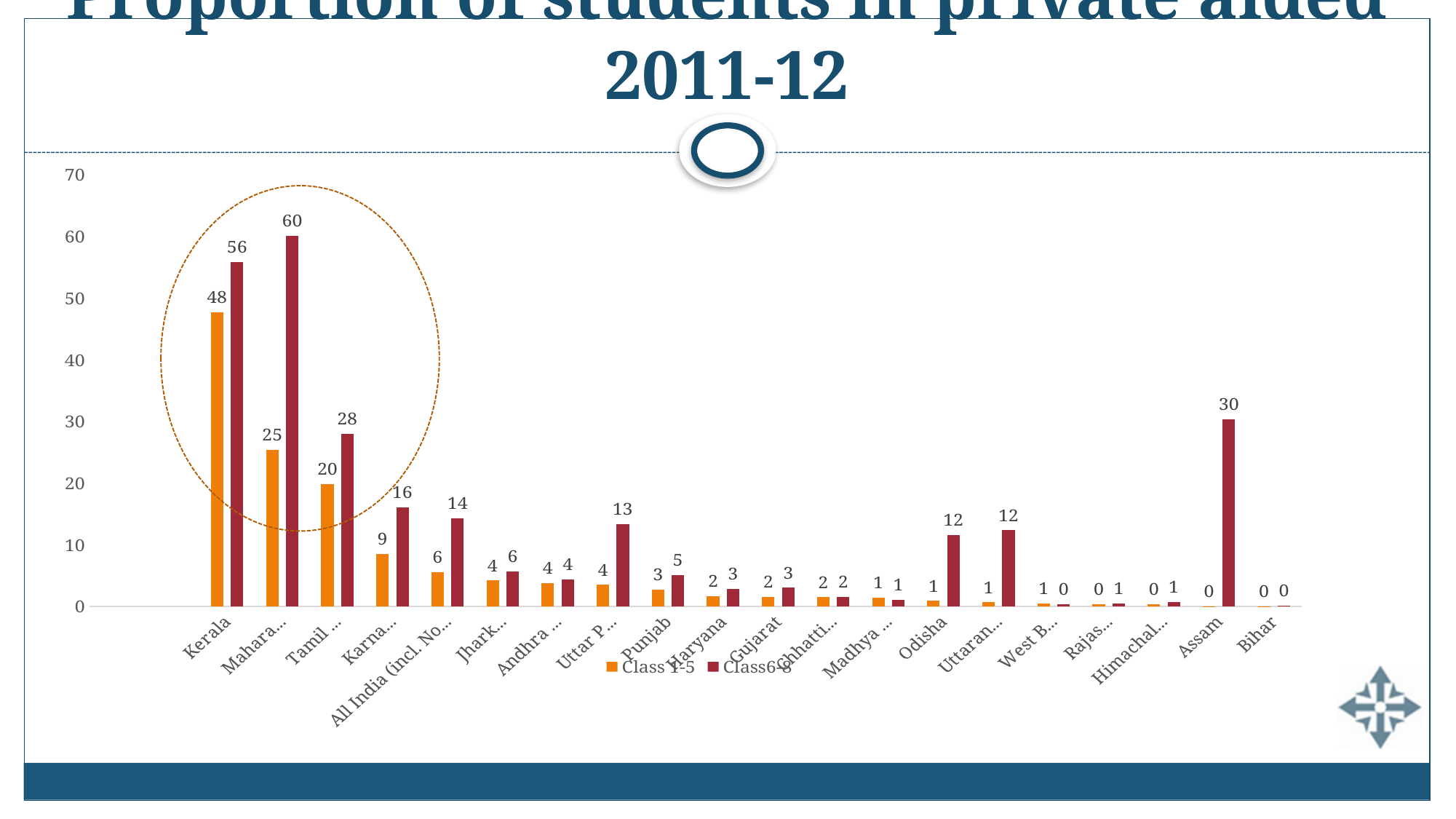
What is the Class 1-5 value for Kerala? 48 Which category has the highest Class 1-5 value? Kerala Which is larger for Punjab: the Class 1-5 value or the Class 6-8 value? Class 6-8 How many series does the legend list? 2 What is the Class 6-8 value for Odisha? 12 What colour are the Class 1-5 bars? orange How many categories are shown on the x axis? 20 What type of chart is shown on the slide? bar chart What is the Class 6-8 value for Assam? 30 Is the Class 6-8 value for Assam greater or less than 20? greater What is the Class 1-5 value for Bihar? 0 What is the difference between the Class 6-8 and Class 1-5 values for Kerala? 8